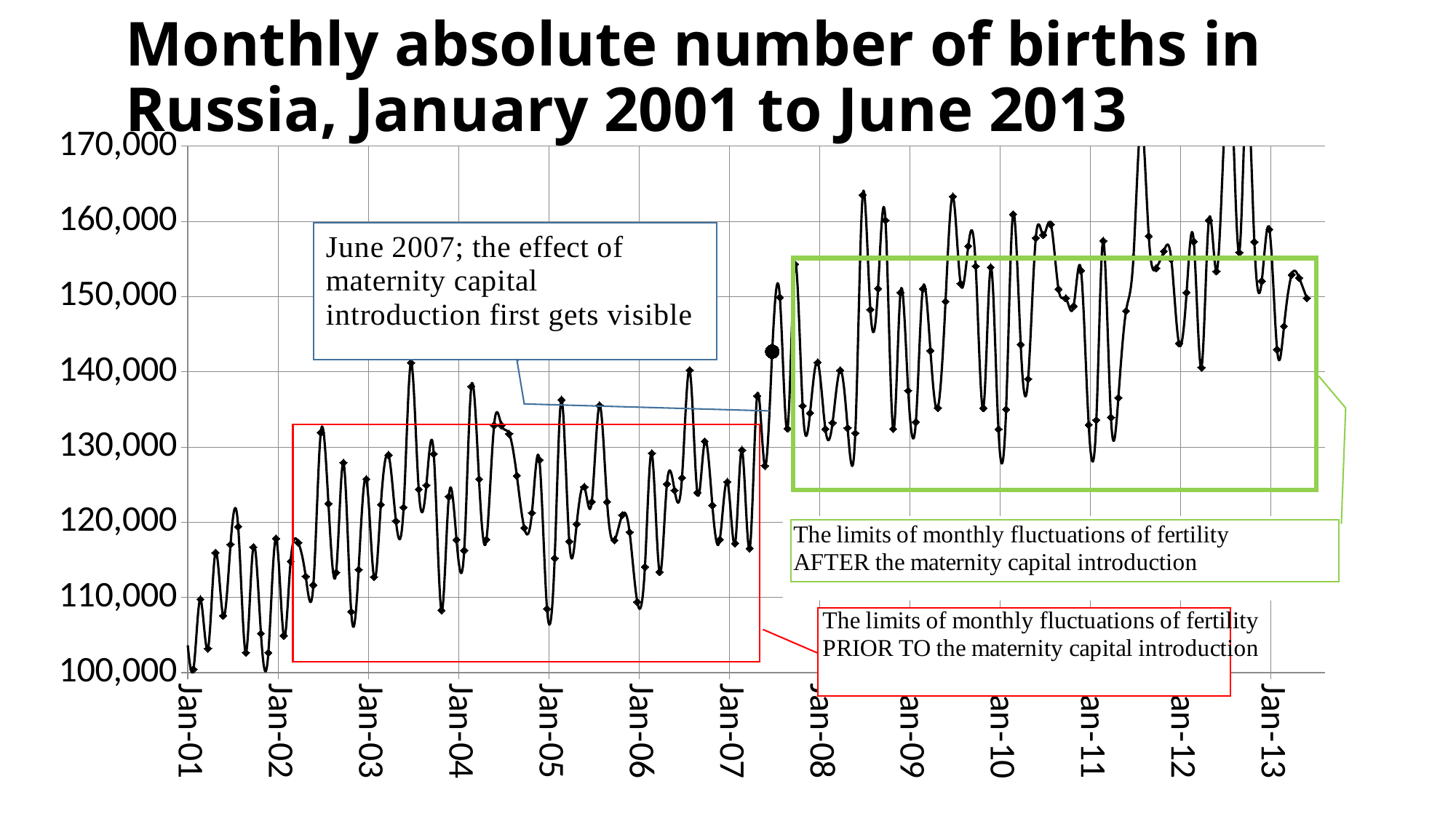
Is the value for Jan-05 greater or less than 120,000? less Is the value for Jan-02 greater or less than 130,000? less According to the annotation, in which month does the effect of the maternity capital introduction first get visible? June 2007 Is the value for Jan-01 greater or less than 110,000? less In which year does the lowest value on the chart occur? 2001 Which is larger, the value for Jan-02 or the value for Jan-08? Jan-08 Overall, do the monthly birth numbers rise or fall from Jan-01 to Jan-13? rise What kind of chart is shown on the slide? line chart Which is larger, the value for Jan-01 or the value for Jan-13? Jan-13 How many year labels are shown on the x axis? 13